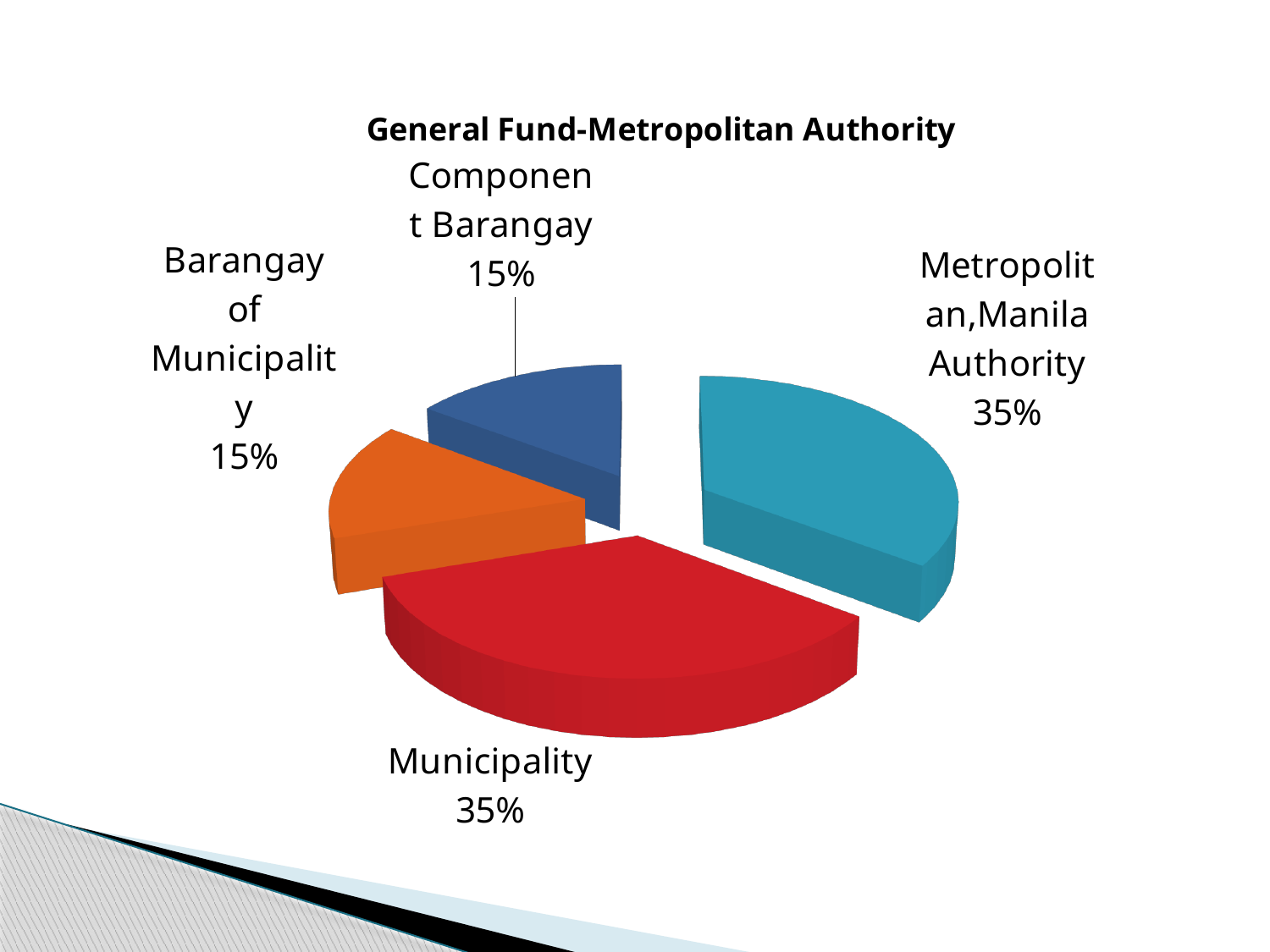
What kind of chart is shown on the slide? Pie chart What is the title of the chart? General Fund-Metropolitan Authority What colour is the Municipality slice? Red What share of the pie does Municipality hold? 35% What is the difference between the share for Municipality and the share for Component Barangay? 20% What share of the pie does Component Barangay hold? 15% How many slices does the pie chart have? 4 What is the combined share of Component Barangay and Barangay of Municipality? 30% Which is larger, the share for Municipality or the share for Component Barangay? Municipality What share of the pie does Barangay of Municipality hold? 15% Which is larger, the share for Metropolitan,Manila Authority or the share for Barangay of Municipality? Metropolitan,Manila Authority What share of the pie does Metropolitan,Manila Authority hold? 35%